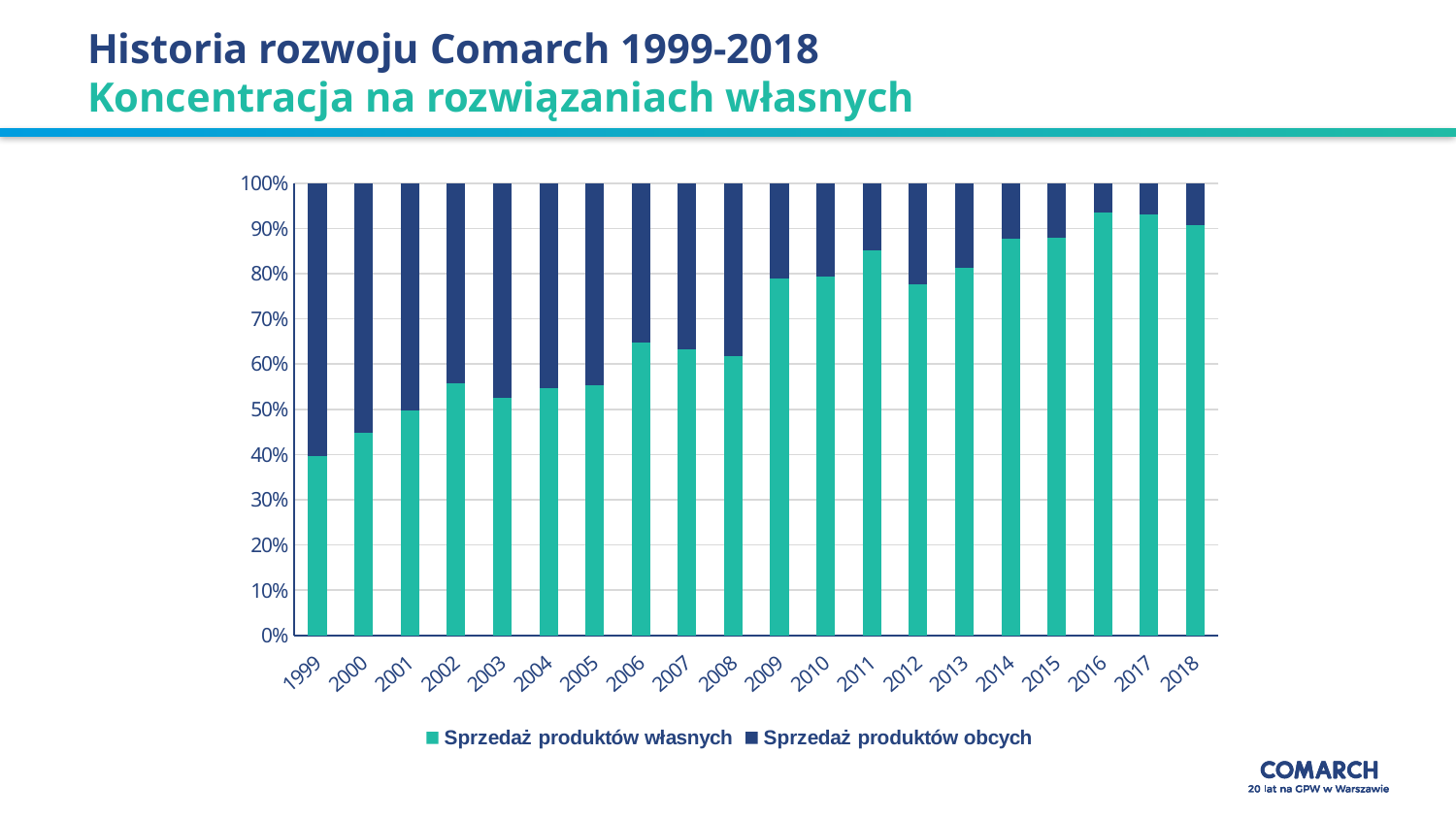
Is the share of 'Sprzedaż produktów własnych' in 1999 greater or less than 50%? less Is the share of 'Sprzedaż produktów własnych' in 2006 greater or less than 60%? greater Is the share of 'Sprzedaż produktów własnych' in 2011 greater or less than 80%? greater What kind of chart is shown on the slide? stacked bar chart Which year has the highest share of 'Sprzedaż produktów obcych'? 1999 How many series does the legend list? 2 How many years (categories) are shown on the x axis of the chart? 20 What is the title of the chart slide? Historia rozwoju Comarch 1999-2018 Koncentracja na rozwiązaniach własnych Does the share of 'Sprzedaż produktów własnych' generally rise or fall from 1999 to 2018? rise Which year has a larger share of 'Sprzedaż produktów własnych', 2003 or 2006? 2006 Which year has the lowest share of 'Sprzedaż produktów własnych'? 1999